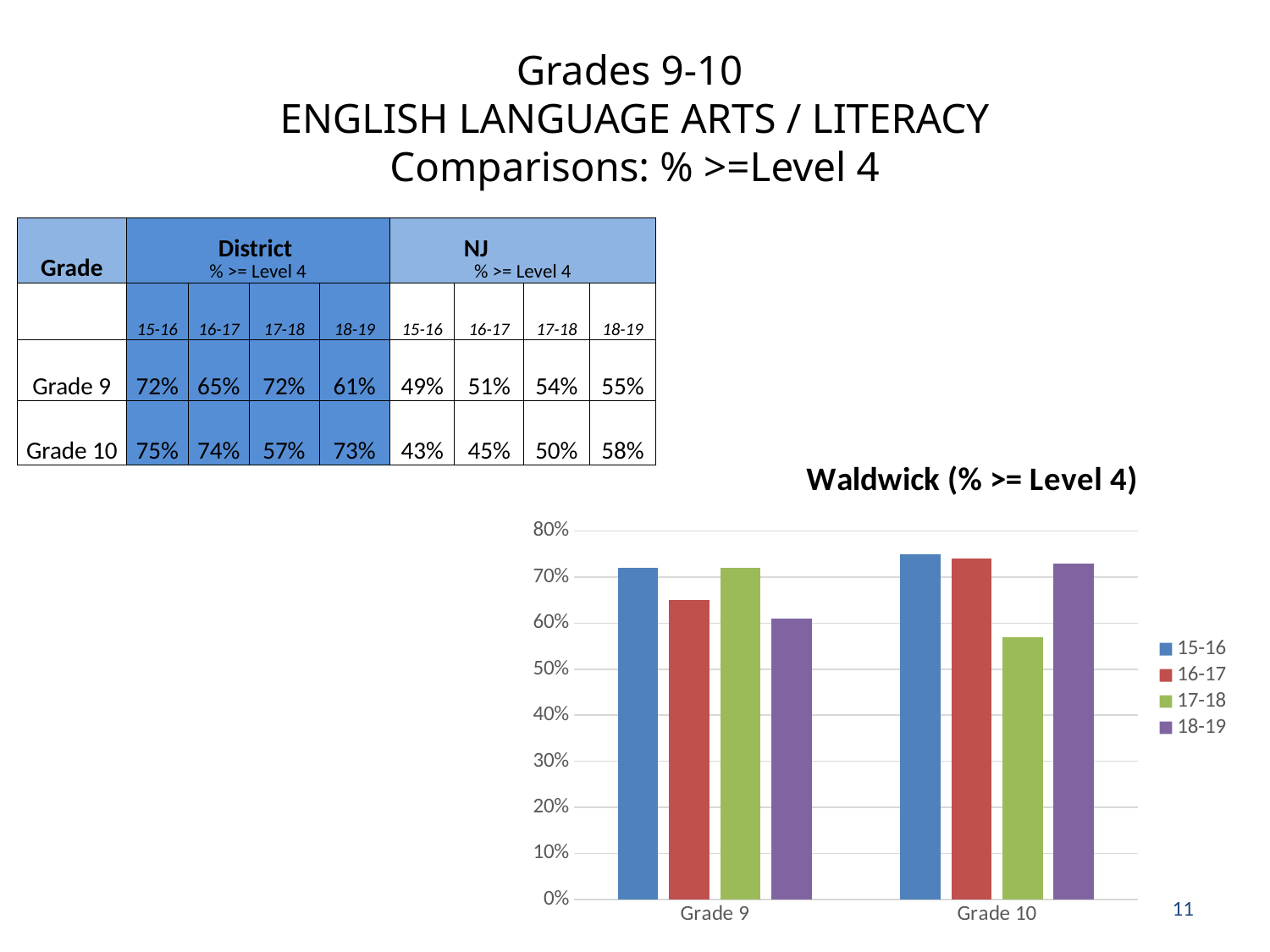
In the Waldwick chart, is the value for Grade 10 in 17-18 greater or less than 60%? less In the Waldwick chart, is the value for Grade 10 in 15-16 greater or less than 70%? greater In the Waldwick chart, what is the value for Grade 10 in 17-18? 57% In the Waldwick chart, what is the value for Grade 9 in 15-16? 72% How many grade categories are shown on the x axis of the Waldwick chart? 2 How many series does the legend of the Waldwick chart list? 4 In the Waldwick chart, which year has the lowest value for Grade 9? 18-19 What colour are the 18-19 bars in the Waldwick chart? purple In the Waldwick chart, what is the difference between Grade 10 in 18-19 and Grade 9 in 18-19? 12% In the Waldwick chart, which is larger: Grade 9 in 16-17 or Grade 10 in 16-17? Grade 10 in 16-17 In the Waldwick chart, which year has the highest value for Grade 10? 15-16 What kind of chart is the "Waldwick (% >= Level 4)" chart? bar chart